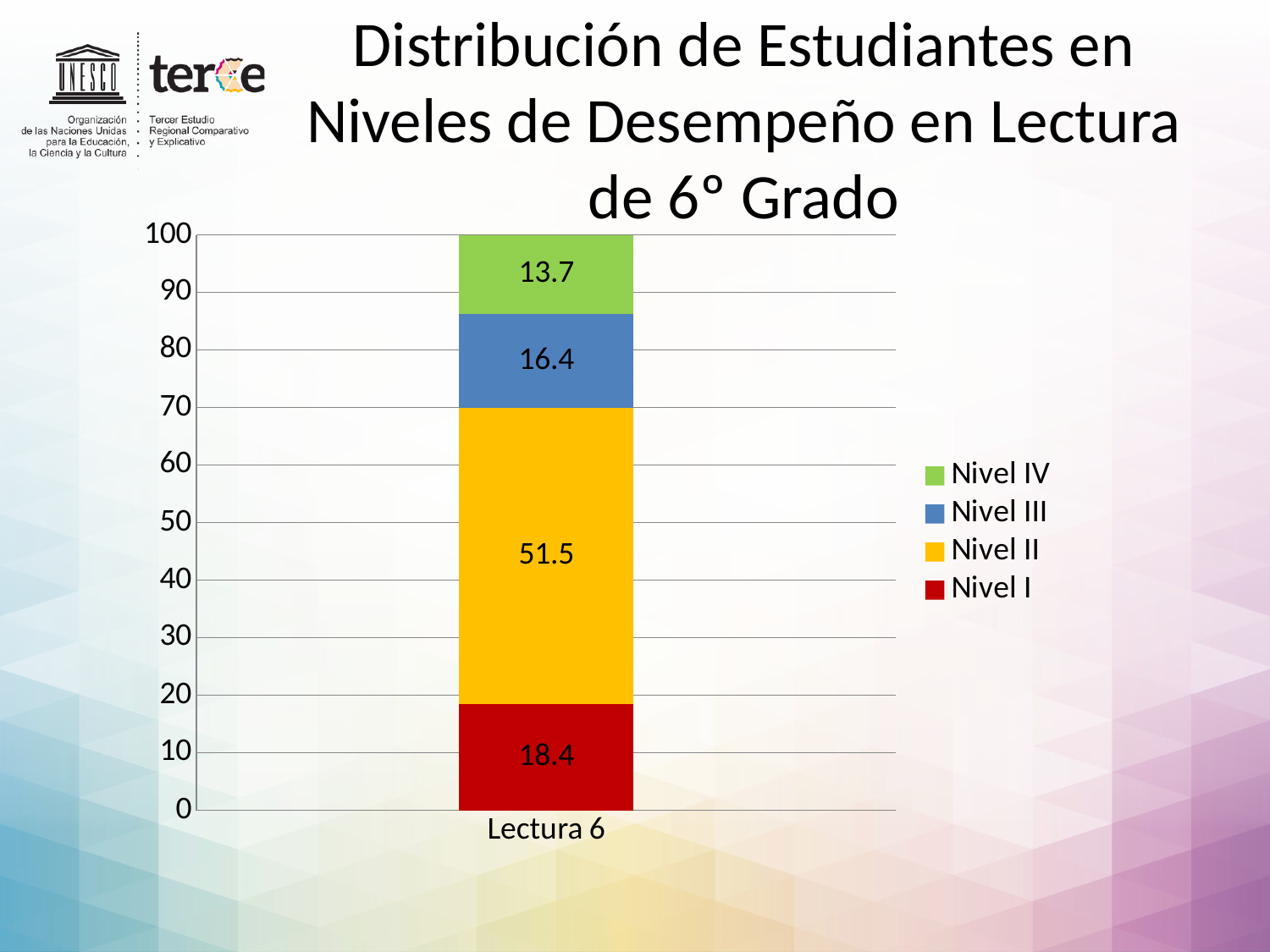
What colour represents Nivel II in the chart? Yellow What is the value for Nivel II in the Lectura 6 bar? 51.5 Which is larger, the value for Nivel I or the value for Nivel III? Nivel I Which level has the lowest value in the Lectura 6 bar? Nivel IV What is the value for Nivel IV in the Lectura 6 bar? 13.7 What is the total of the Lectura 6 stacked bar? 100 How many series does the legend list? 4 What kind of chart is shown on the slide? Stacked bar chart Which level has the highest value in the Lectura 6 bar? Nivel II What is the value for Nivel III in the Lectura 6 bar? 16.4 What is the value for Nivel I in the Lectura 6 bar? 18.4 What is the difference between the Nivel II and Nivel I values? 33.1